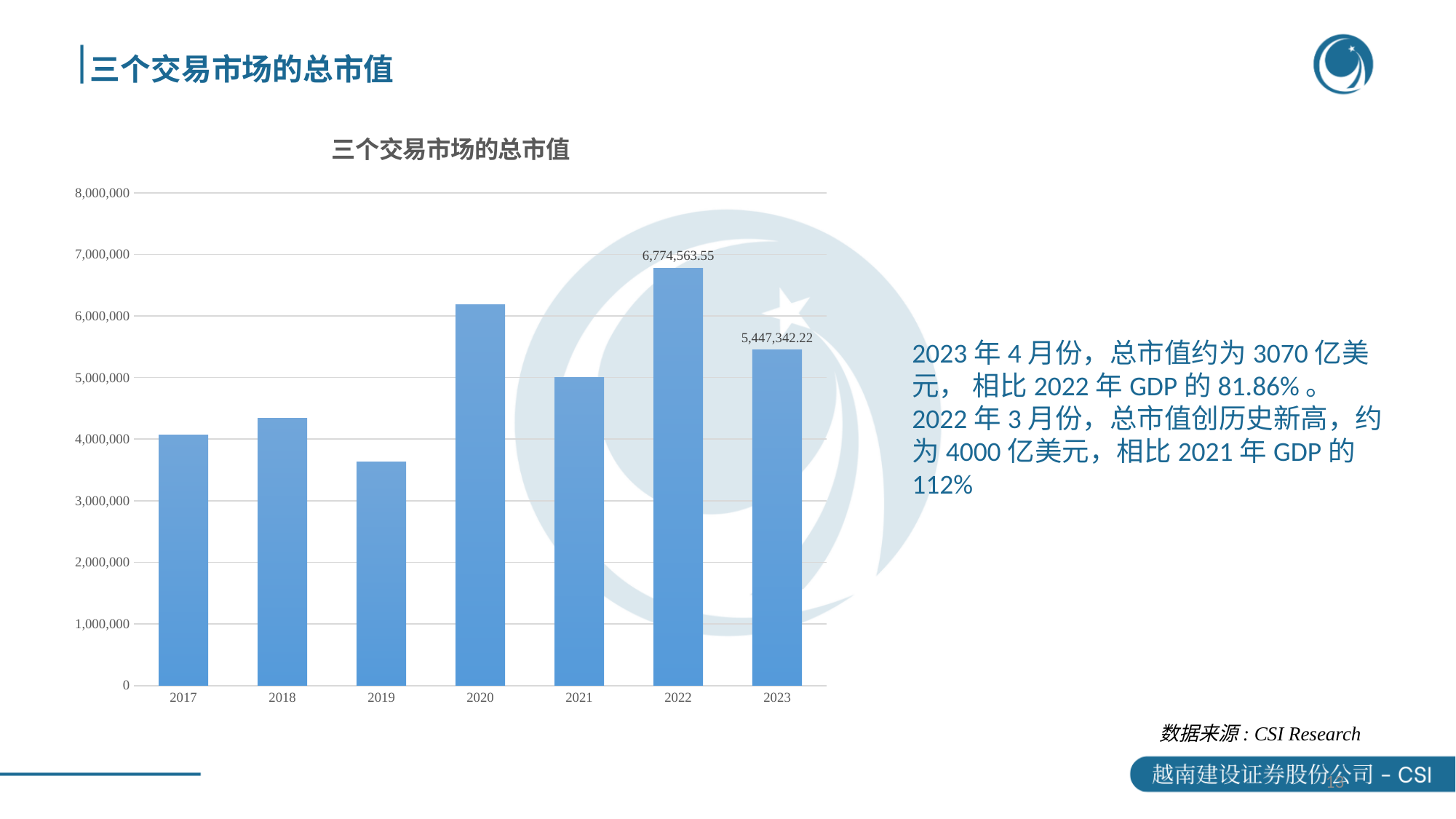
Which year has the larger value, 2020 or 2021? 2020 Which year has the highest total market value in the chart? 2022 What is the difference between the values for 2022 and 2023? 1,327,221.33 Which year has the lowest total market value in the chart? 2019 Is the value for 2019 greater or less than 4,000,000? less Is the value for 2020 greater or less than 6,000,000? greater How many years are shown on the x axis of the chart? 7 What kind of chart is shown on the slide? bar chart What is the title of the chart? 三个交易市场的总市值 What is the value for 2023 in the chart? 5,447,342.22 From 2022 to 2023, does the value rise or fall? fall What is the value for 2022 in the chart? 6,774,563.55